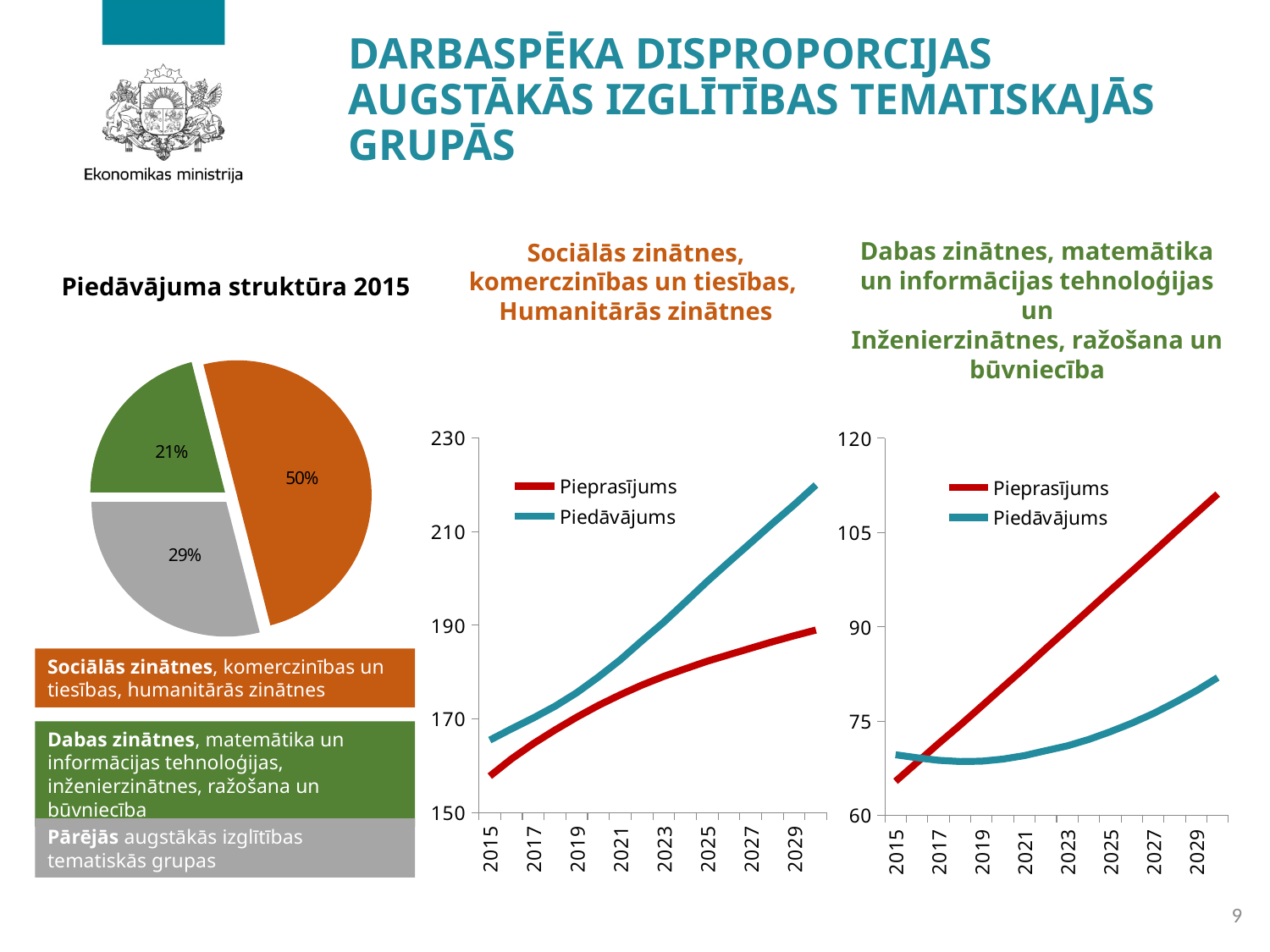
In the pie chart 'Piedāvājuma struktūra 2015', which group has the smallest share? Dabas zinātnes, matemātika un informācijas tehnoloģijas, inženierzinātnes, ražošana un būvniecība How many slices does the pie chart 'Piedāvājuma struktūra 2015' have? 3 In the chart 'Sociālās zinātnes, komerczinības un tiesības, Humanitārās zinātnes', is the Piedāvājums value at the end of the period greater or less than 210? greater In the chart 'Sociālās zinātnes, komerczinības un tiesības, Humanitārās zinātnes', is the Pieprasījums value in 2015 greater or less than 170? less In the pie chart 'Piedāvājuma struktūra 2015', what share does the green slice (Dabas zinātnes, matemātika un informācijas tehnoloģijas, inženierzinātnes, ražošana un būvniecība) have? 21% How many series does the legend of the chart 'Dabas zinātnes, matemātika un informācijas tehnoloģijas un Inženierzinātnes, ražošana un būvniecība' list? 2 What kind of chart is the chart titled 'Sociālās zinātnes, komerczinības un tiesības, Humanitārās zinātnes'? Line chart In the pie chart 'Piedāvājuma struktūra 2015', what is the difference in percentage points between the grey slice (Pārējās) and the green slice (Dabas zinātnes)? 8 In the chart 'Sociālās zinātnes, komerczinības un tiesības, Humanitārās zinātnes', does the Piedāvājums line rise or fall from 2015 to 2029? Rises In the pie chart 'Piedāvājuma struktūra 2015', what share does the orange slice (Sociālās zinātnes, komerczinības un tiesības, humanitārās zinātnes) have? 50% In the chart 'Dabas zinātnes, matemātika un informācijas tehnoloģijas un Inženierzinātnes, ražošana un būvniecība', which series is higher at the end of the period, Pieprasījums or Piedāvājums? Pieprasījums In the chart 'Dabas zinātnes, matemātika un informācijas tehnoloģijas un Inženierzinātnes, ražošana un būvniecība', is the Pieprasījums value at the end of the period greater or less than 105? greater